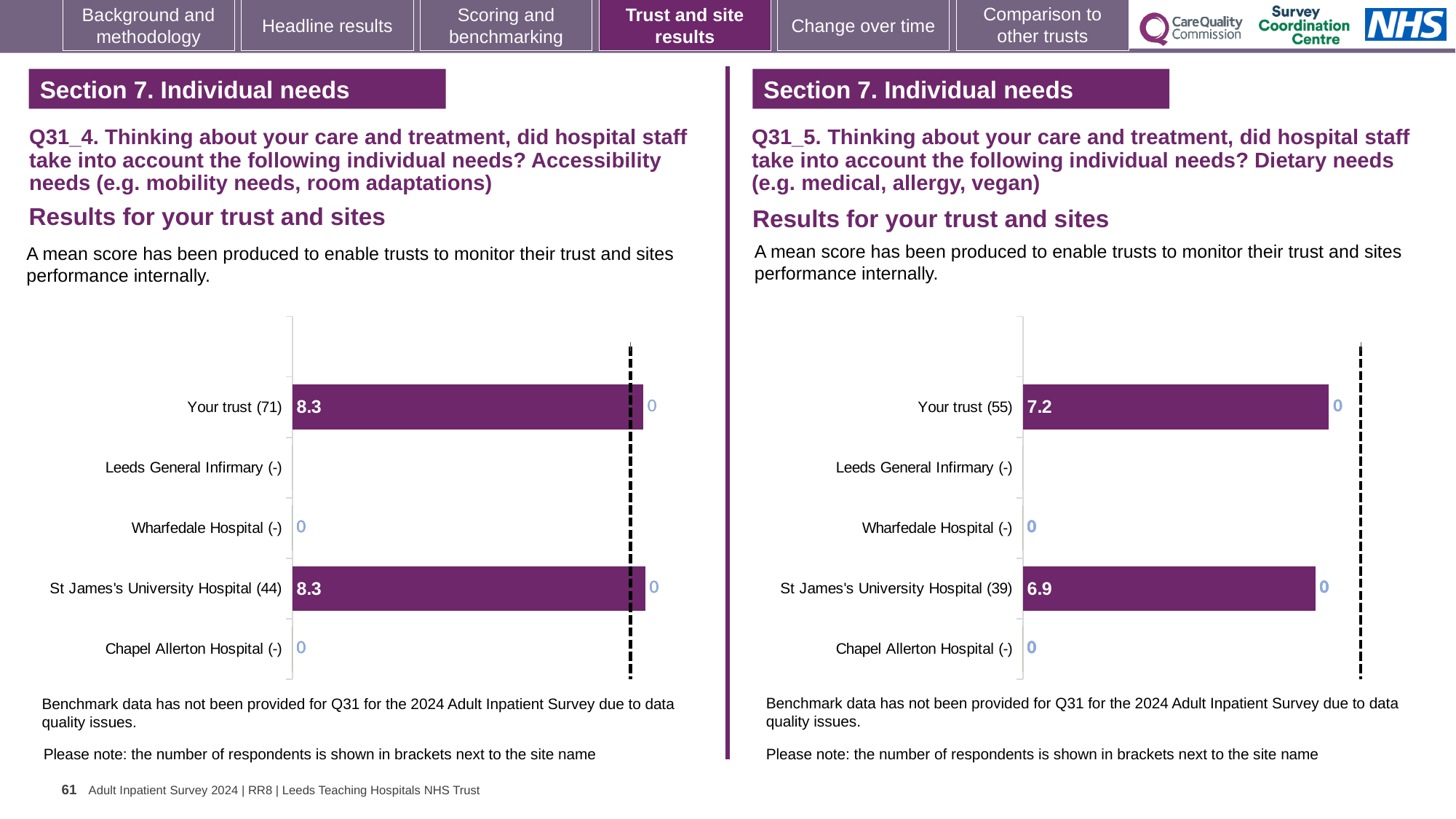
How many site/trust categories are listed on the Q31_5 (Dietary needs) chart? 5 On the Q31_5 (Dietary needs) chart, how many respondents are shown in brackets for St James's University Hospital? 39 On the Q31_4 (Accessibility needs) chart, how many respondents are shown in brackets for Your trust? 71 On the Q31_5 (Dietary needs) chart, what is the difference between the mean score for Your trust and for St James's University Hospital? 0.3 On the Q31_4 (Accessibility needs) chart, what is the mean score for Your trust? 8.3 On the Q31_5 (Dietary needs) chart, which has the higher mean score: Your trust or St James's University Hospital? Your trust On the Q31_4 (Accessibility needs) chart, what is the mean score for St James's University Hospital? 8.3 What type of chart is used on the Q31_4 (Accessibility needs) side of the slide? Bar chart On the Q31_5 (Dietary needs) chart, what is the mean score for St James's University Hospital? 6.9 On the Q31_5 (Dietary needs) chart, what is the mean score for Your trust? 7.2 Is the mean score for Your trust on the Q31_4 chart higher than, lower than, or equal to the mean score for St James's University Hospital on the same chart? Equal On the Q31_4 (Accessibility needs) chart, which category is listed first at the top? Your trust (71)